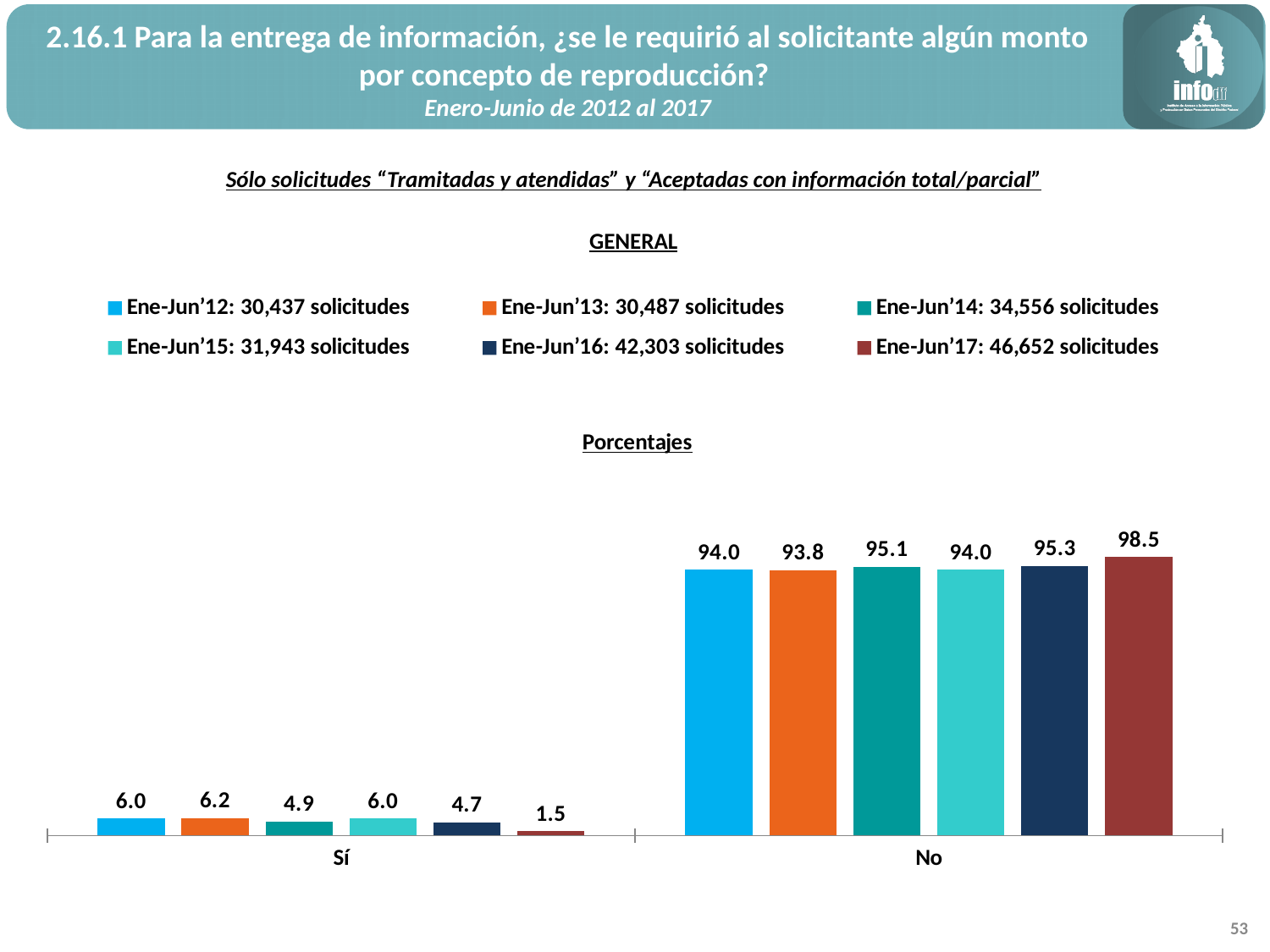
What is the difference between the Ene-Jun'12 and Ene-Jun'17 values in the "Sí" category? 4.5 How many categories are shown on the x axis? 2 What is the difference between the Ene-Jun'17 and Ene-Jun'12 values in the "No" category? 4.5 Which is larger in the "Sí" category: Ene-Jun'13 or Ene-Jun'16? Ene-Jun'13 What is the value for Ene-Jun'14 in the "No" category? 95.1 Which series has the lowest value in the "Sí" category? Ene-Jun'17 According to the legend, how many solicitudes were there in Ene-Jun'16? 42,303 solicitudes How many series does the legend list? 6 What is the value for Ene-Jun'17 in the "Sí" category? 1.5 What is the value for Ene-Jun'13 in the "Sí" category? 6.2 Which series has the highest value in the "No" category? Ene-Jun'17 What kind of chart is shown on the slide? Bar chart